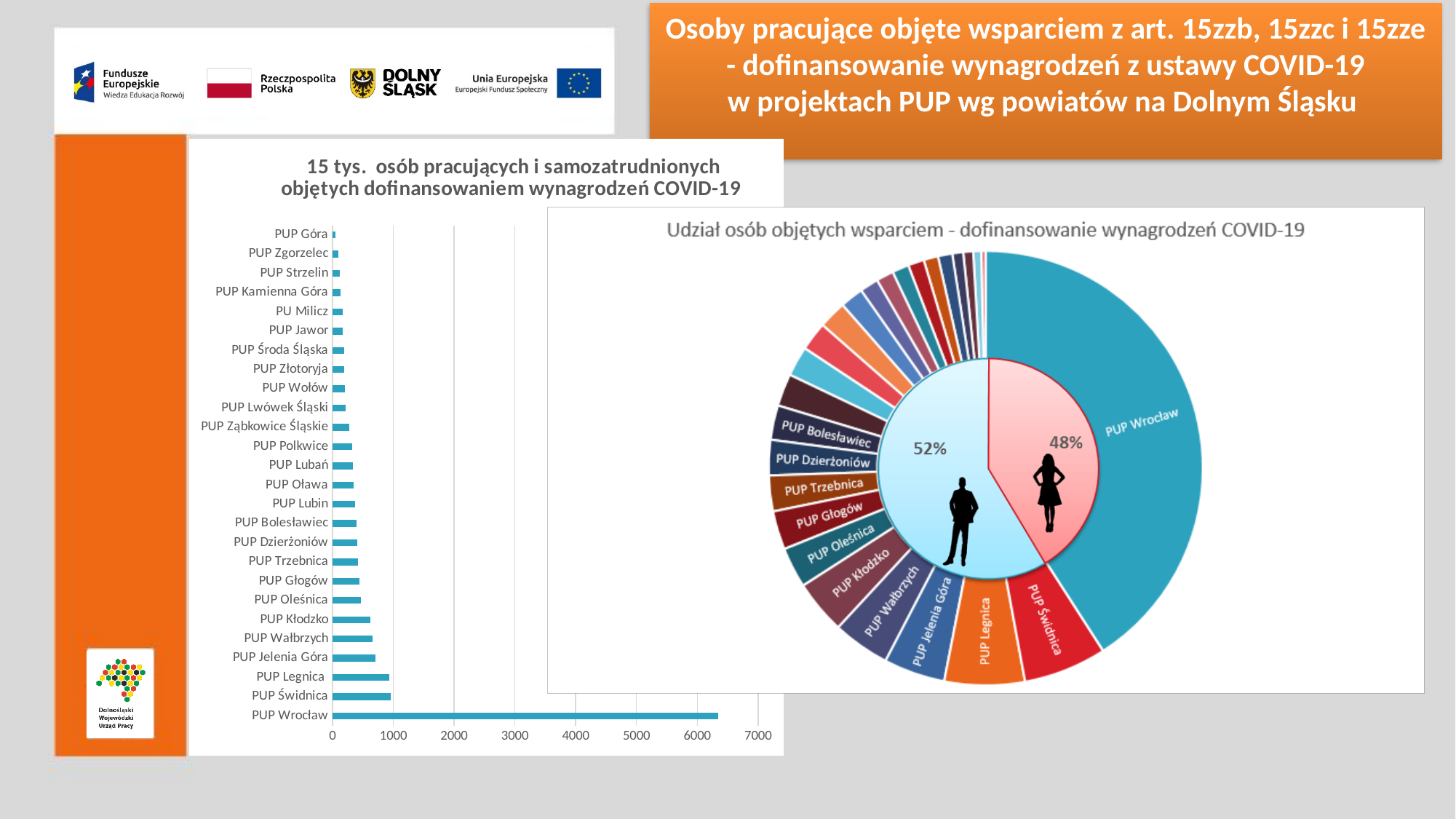
In the bar chart on the left, which is larger: the value for PUP Wrocław or the value for PUP Legnica? PUP Wrocław In the bar chart on the left, which PUP has the lowest value? PUP Góra In the bar chart on the left, is the value for PUP Kłodzko greater or less than 1000? less In the bar chart on the left, which PUP has the highest value? PUP Wrocław In the bar chart on the left, what is the highest value shown on the horizontal axis? 7000 In the bar chart on the left, how many PUP categories are plotted? 26 What kind of chart is the chart on the left titled '15 tys. osób pracujących i samozatrudnionych objętych dofinansowaniem wynagrodzeń COVID-19'? bar chart In the pie chart on the right, what percentage is shown on the blue inner segment with the male figure? 52% In the bar chart on the left, is the value for PUP Wrocław greater or less than 6000? greater In the pie chart on the right titled 'Udział osób objętych wsparciem - dofinansowanie wynagrodzeń COVID-19', which PUP has the largest slice in the outer ring? PUP Wrocław In the pie chart on the right, what percentage is shown on the pink inner segment with the female figure? 48%